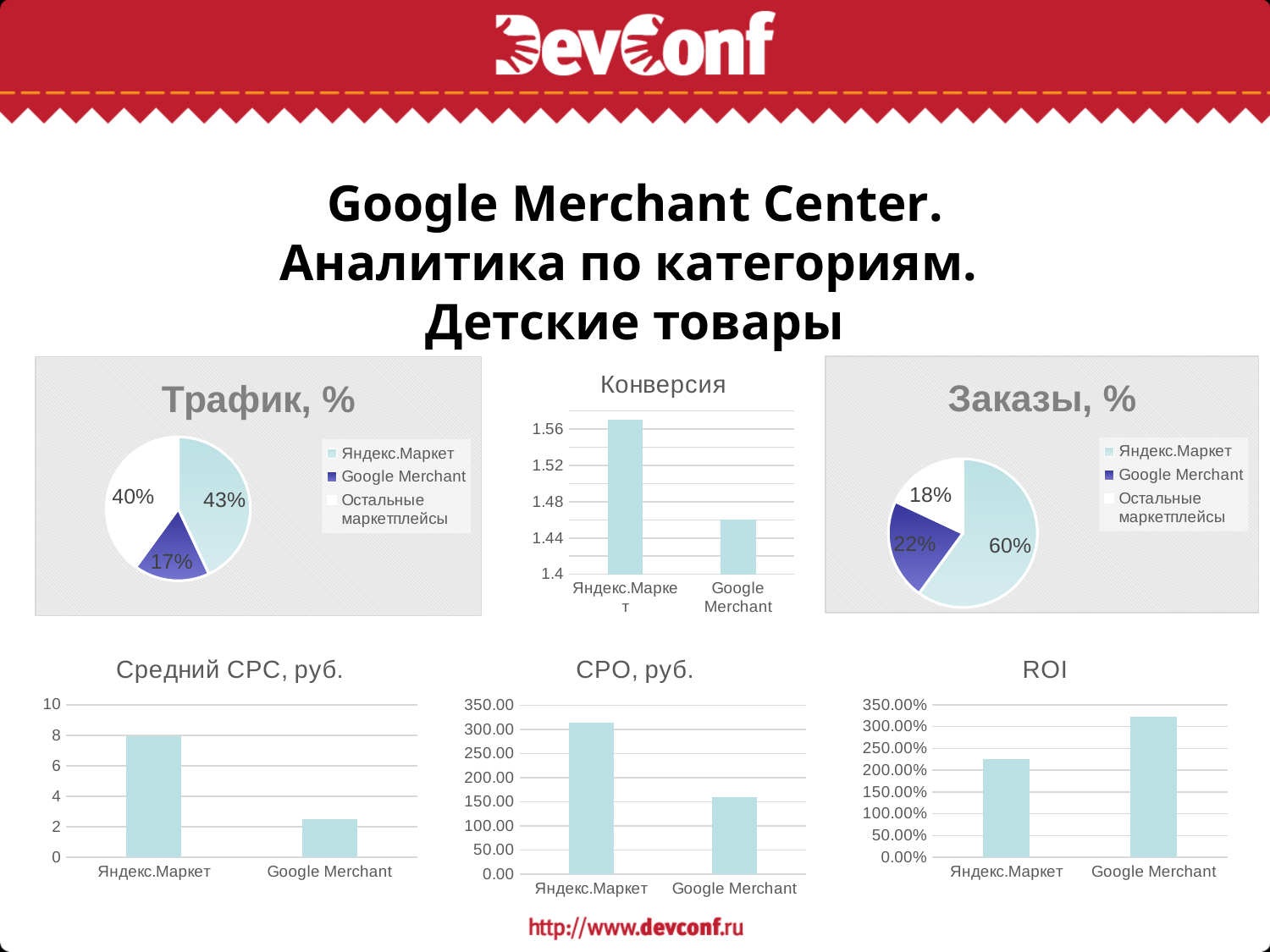
In the 'Заказы, %' pie chart, which category has the smallest share? Остальные маркетплейсы In the 'CPO, руб.' chart, is the value for Яндекс.Маркет greater or less than 300.00? greater In the 'Трафик, %' pie chart, what share does Google Merchant have? 17% In the 'Заказы, %' pie chart, what share does Яндекс.Маркет have? 60% In the 'Трафик, %' pie chart, what share does Яндекс.Маркет have? 43% In the 'Трафик, %' pie chart, how many categories does the legend list? 3 In the 'Конверсия' chart, is the value for Google Merchant greater or less than 1.48? less In the 'ROI' chart, which category has the highest value? Google Merchant What kind of chart is the 'ROI' chart? bar chart In the 'Заказы, %' pie chart, what is the difference between the Яндекс.Маркет share and the Google Merchant share? 38% In the 'Конверсия' chart, which category has the higher value? Яндекс.Маркет